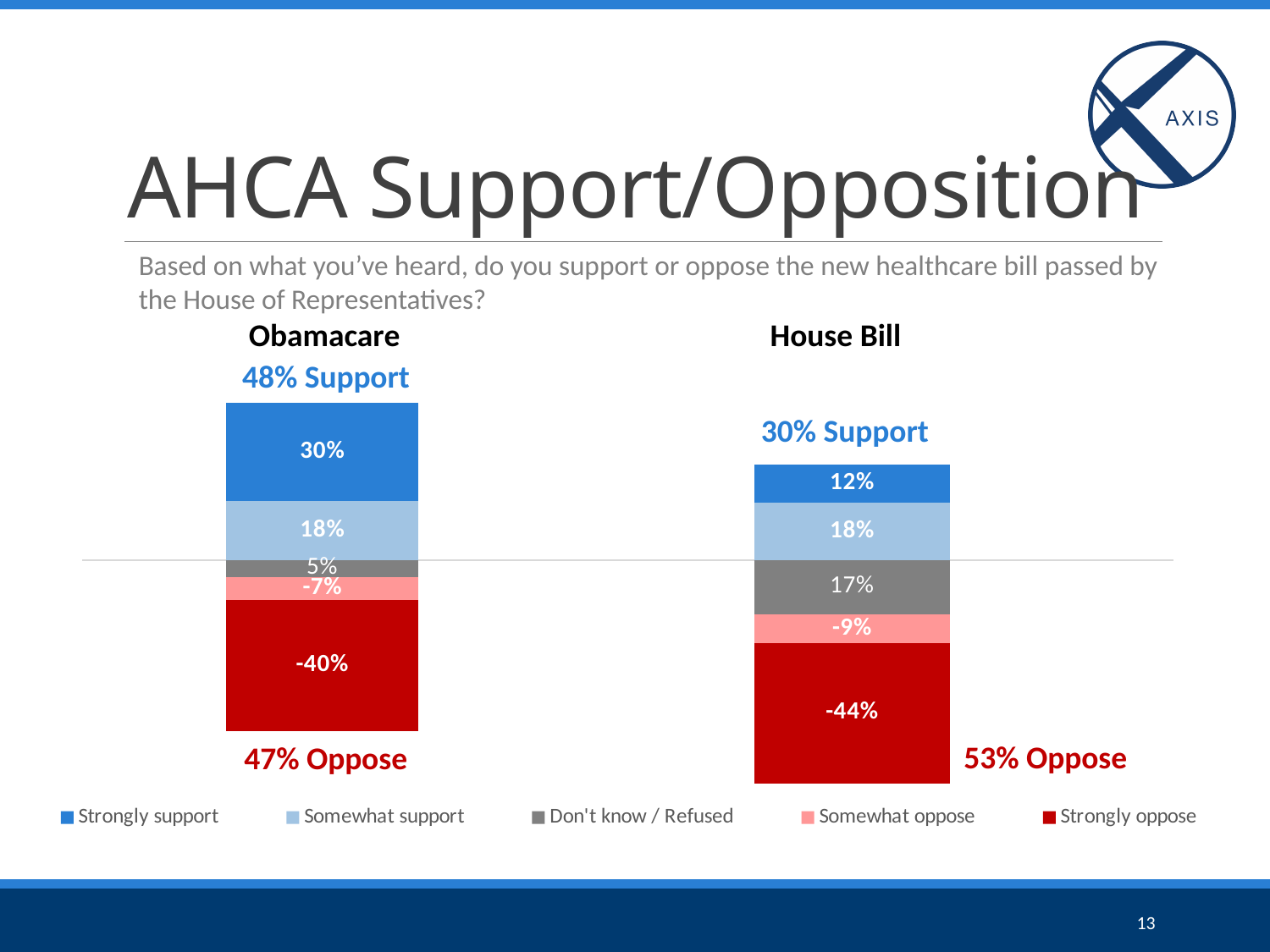
How many categories (bars) are shown in the chart? 2 What percentage of respondents strongly support the House Bill? 12% What is the Somewhat oppose value for Obamacare? -7% What is the Don't know / Refused value for the House Bill? 17% What percentage of respondents strongly support Obamacare? 30% Which has the larger Strongly support share, Obamacare or the House Bill? Obamacare What is the Strongly oppose value for the House Bill? -44% What is the difference between the Strongly support values for Obamacare and the House Bill? 18% What is the total support shown for Obamacare? 48% Support What is the total opposition shown for the House Bill? 53% Oppose How many series does the legend list? 5 What kind of chart is shown on the slide? Stacked bar chart